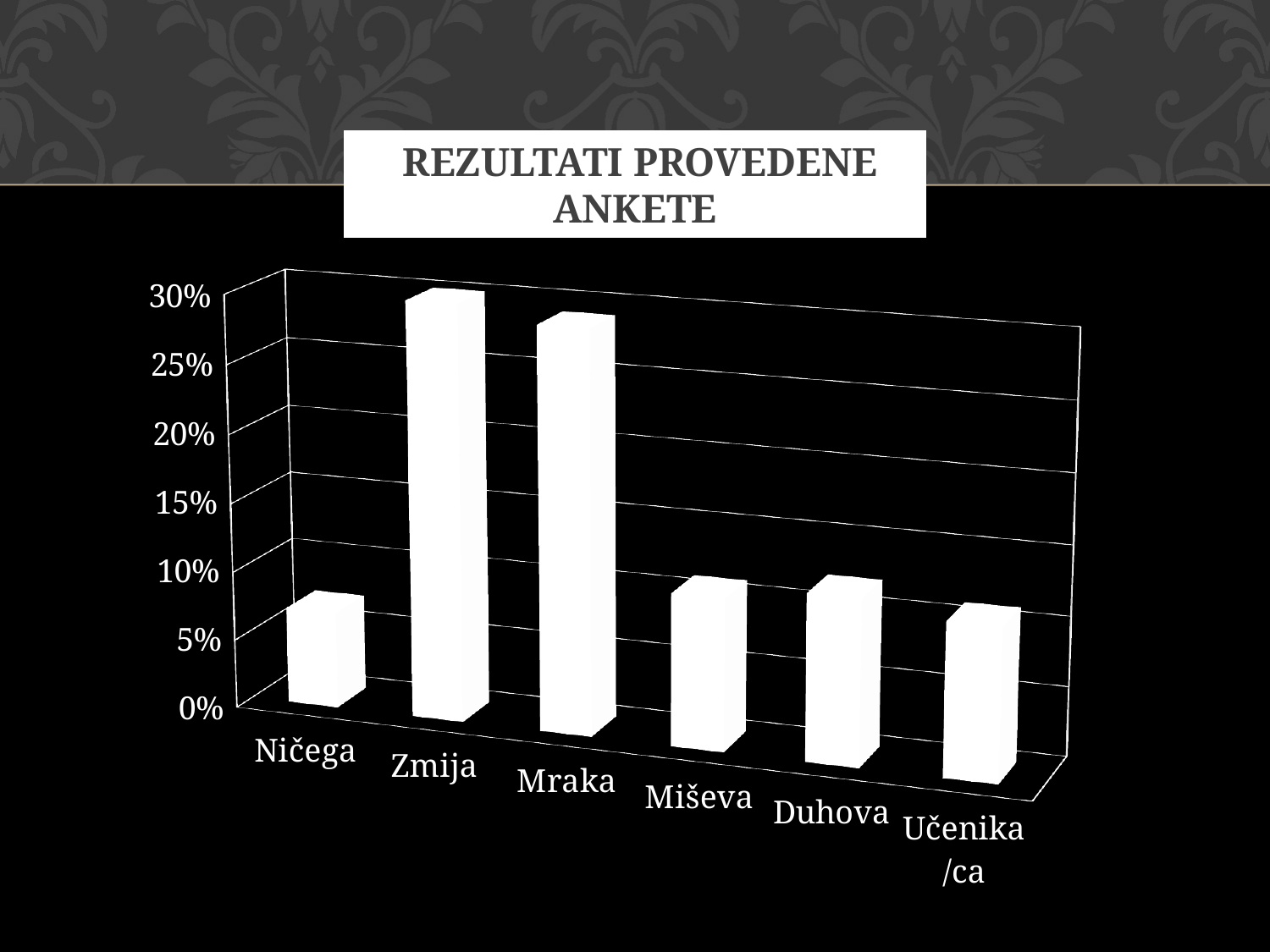
Which is larger, the value for Zmija or the value for Miševa? Zmija How many categories are shown on the x axis of the chart? 6 Which category has the highest value in the chart? Zmija Is the value for Miševa greater or less than 15%? less Which is larger, the value for Mraka or the value for Ničega? Mraka Is the value for Ničega greater or less than 10%? less What kind of chart is shown on the slide? bar chart Is the value for Mraka greater or less than 20%? greater What is the title of the chart? REZULTATI PROVEDENE ANKETE